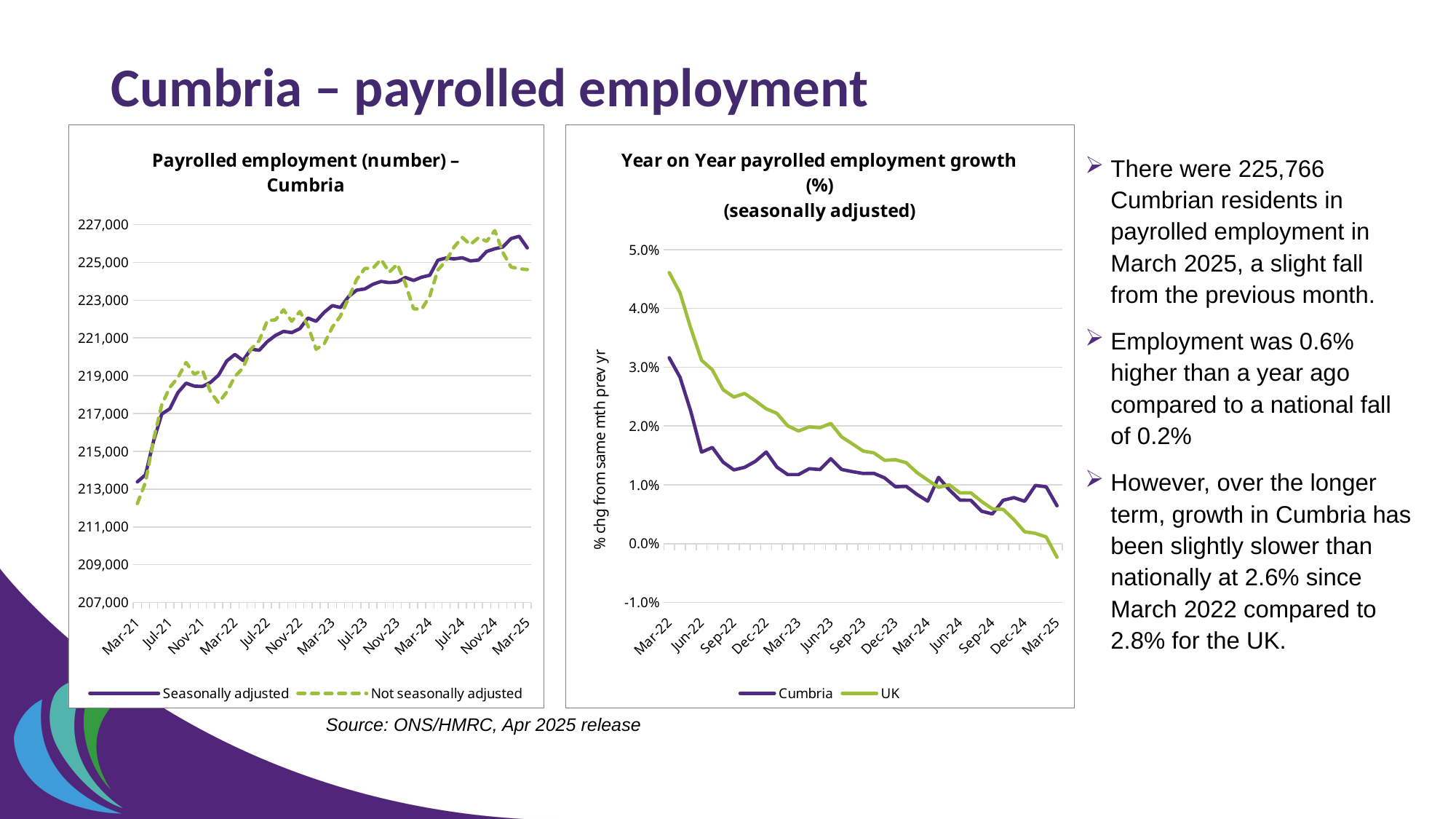
In the right chart, 'Year on Year payrolled employment growth (%)', is the UK value at Mar-22 greater or less than 4.0%? greater In the left chart, 'Payrolled employment (number) – Cumbria', do the values generally rise or fall from Mar-21 to Mar-25? Rise In the left chart, 'Payrolled employment (number) – Cumbria', is the not seasonally adjusted value at Mar-21 greater or less than 213,000? less In the left chart, 'Payrolled employment (number) – Cumbria', is the seasonally adjusted value at Mar-25 greater or less than 225,000? greater How many series does the legend of the right chart, 'Year on Year payrolled employment growth (%)', list? 2 How many series does the legend of the left chart, 'Payrolled employment (number) – Cumbria', list? 2 What kind of chart is the right chart, 'Year on Year payrolled employment growth (%)'? Line chart What kind of chart is the left chart, 'Payrolled employment (number) – Cumbria'? Line chart In the left chart, 'Payrolled employment (number) – Cumbria', which series is drawn with a dashed line? Not seasonally adjusted In the right chart, 'Year on Year payrolled employment growth (%)', which series has the higher value at Mar-22, Cumbria or UK? UK In the right chart, 'Year on Year payrolled employment growth (%)', do the values generally rise or fall from Mar-22 to Mar-25? Fall